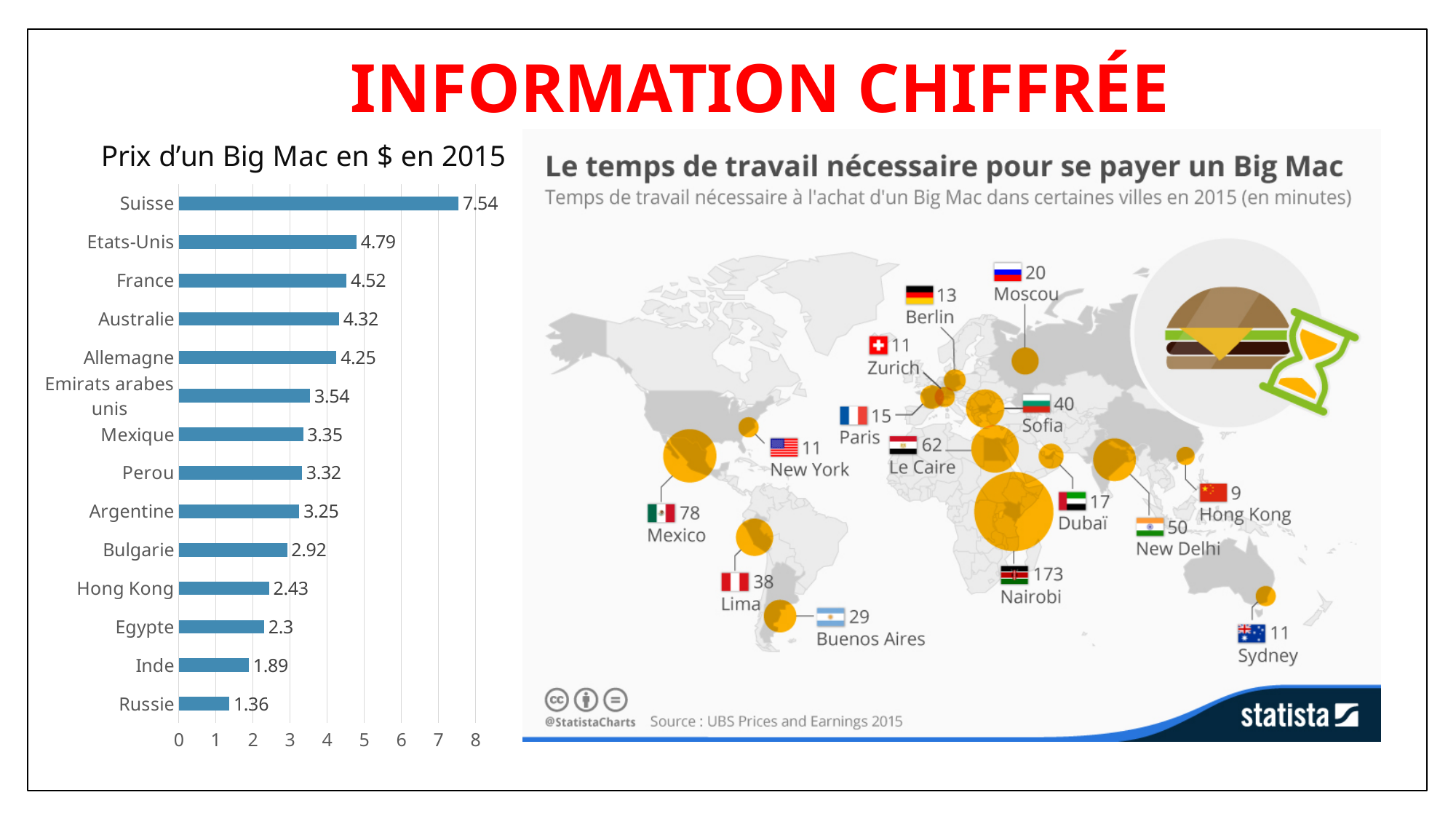
In the bar chart 'Prix d'un Big Mac en $ en 2015', which country has the highest value? Suisse In the map infographic on the right, how many minutes of work are needed to buy a Big Mac in Nairobi? 173 In the bar chart 'Prix d'un Big Mac en $ en 2015', which country has the lowest value? Russie In the bar chart 'Prix d'un Big Mac en $ en 2015', what is the value for France? 4.52 What kind of chart is 'Prix d'un Big Mac en $ en 2015'? Bar chart In the map infographic on the right, which city has the lowest number of minutes shown? Hong Kong In the bar chart 'Prix d'un Big Mac en $ en 2015', how many countries are shown? 14 In the bar chart 'Prix d'un Big Mac en $ en 2015', what is the value for Emirats arabes unis? 3.54 In the bar chart 'Prix d'un Big Mac en $ en 2015', what is the difference between the values for Suisse and Etats-Unis? 2.75 In the map infographic on the right, what is the difference in minutes between Mexico and Lima? 40 In the bar chart 'Prix d'un Big Mac en $ en 2015', what is the value for Inde? 1.89 In the bar chart 'Prix d'un Big Mac en $ en 2015', which is larger, the value for Australie or the value for Allemagne? Australie